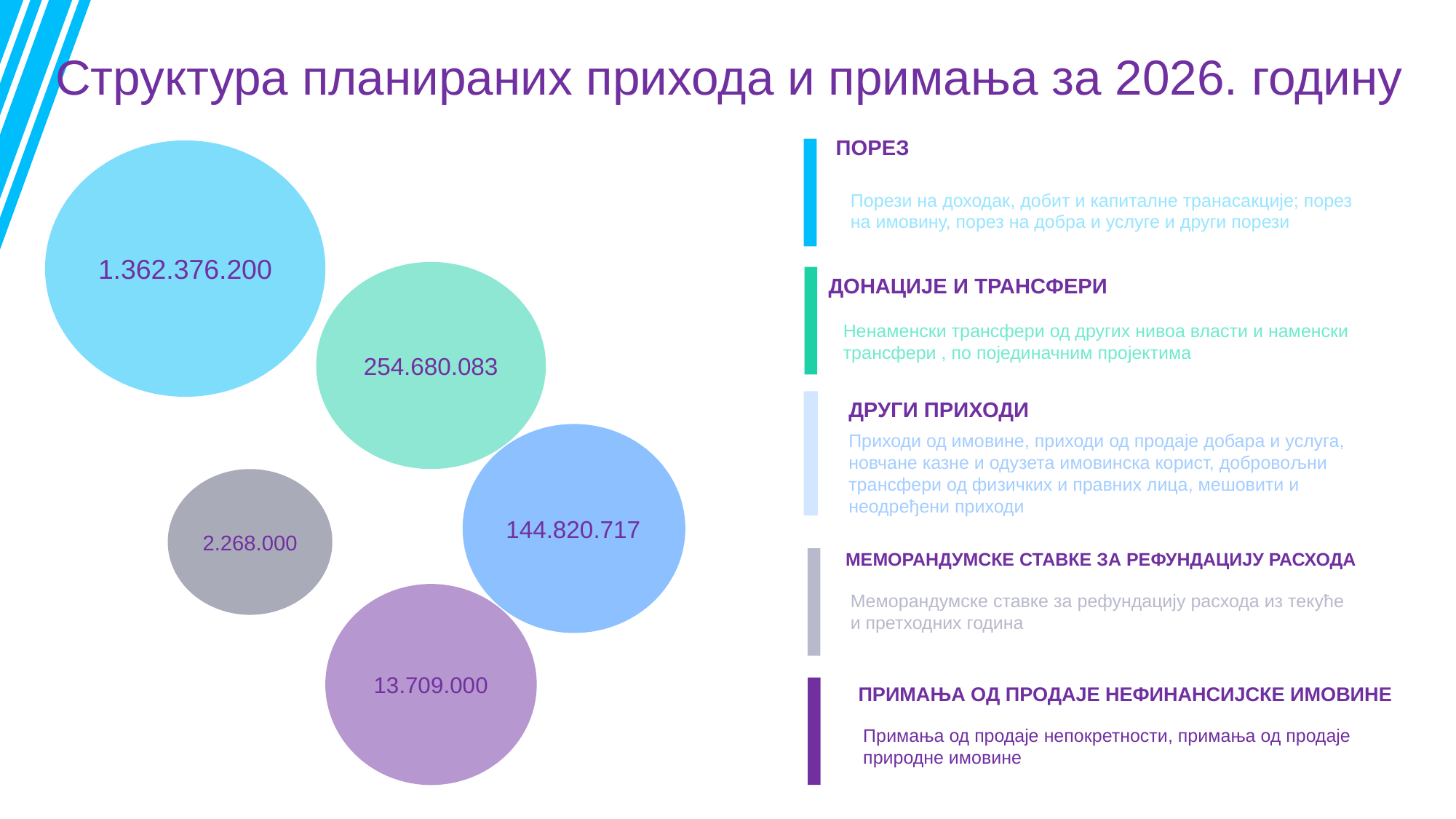
What is the value shown in the green bubble? 254.680.083 What is the value shown in the purple bubble? 13.709.000 What is the value shown in the largest bubble? 1.362.376.200 What is the difference between the largest bubble value (1.362.376.200) and the green bubble value (254.680.083)? 1.107.696.117 What kind of chart is shown on the slide? Bubble chart What is the value shown in the grey bubble? 2.268.000 What is the difference between the purple bubble value (13.709.000) and the grey bubble value (2.268.000)? 11.441.000 Which category has the highest value in the chart? ПОРЕЗ Which value is the smallest among the bubbles? 2.268.000 How many categories does the legend on the right list? 5 Which is larger: the value in the green bubble or the value in the blue bubble labelled 144.820.717? The green bubble (254.680.083) How many bubbles (categories) are plotted in the chart? 5